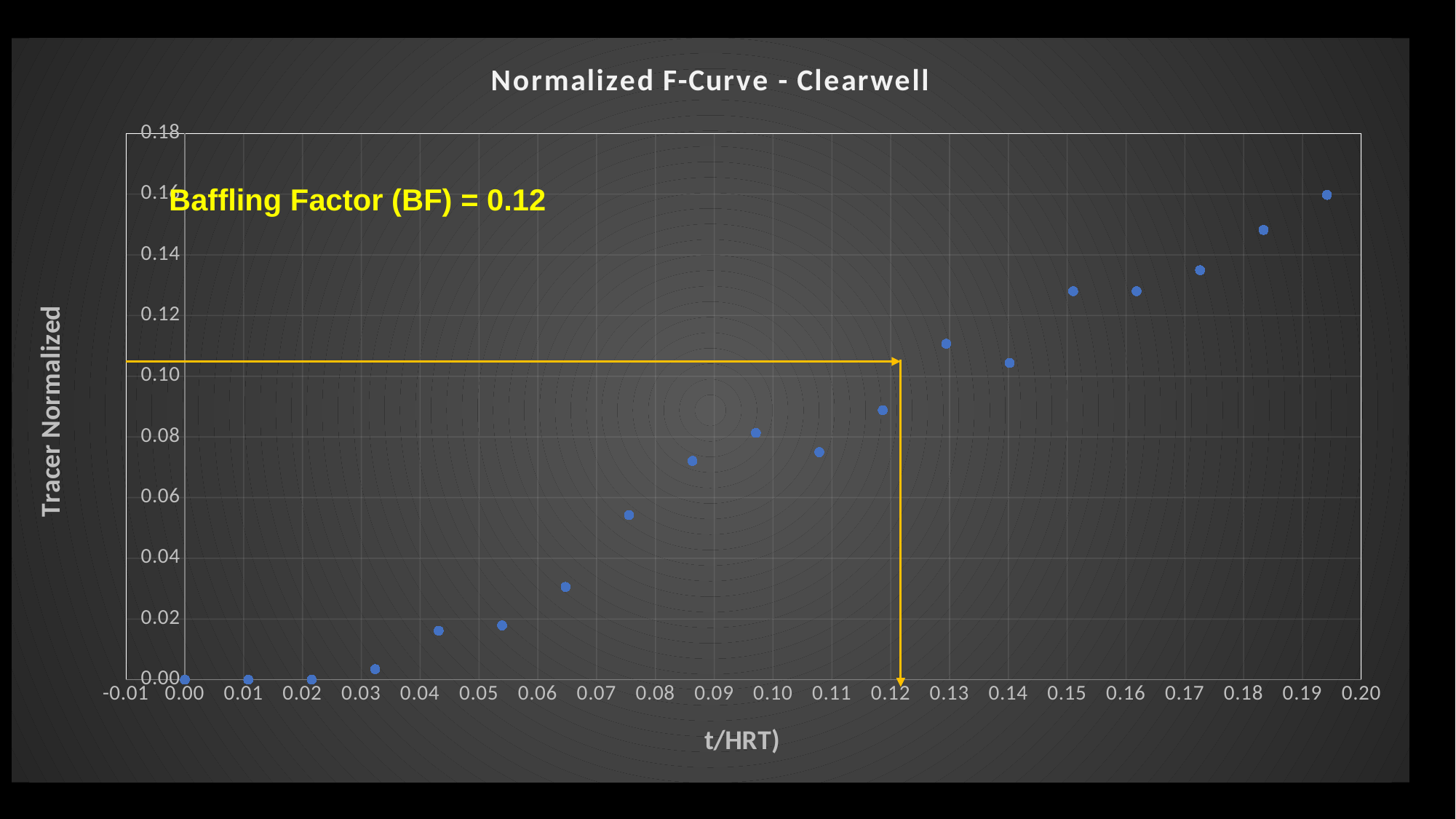
What kind of chart is shown on the slide? scatter chart What is the title of the chart? Normalized F-Curve - Clearwell Is the value of the point near t/HRT = 0.08 greater or less than 0.06? less Which point has the highest Tracer Normalized value: the one near t/HRT = 0.12 or the one near t/HRT = 0.13? the one near 0.13 Is the value of the point near t/HRT = 0.04 greater or less than 0.02? less What is the label of the y axis? Tracer Normalized Is the value of the point near t/HRT = 0.19 greater or less than 0.14? greater What Baffling Factor (BF) value is annotated on the chart? 0.12 Do the plotted values generally rise or fall as t/HRT increases? rise